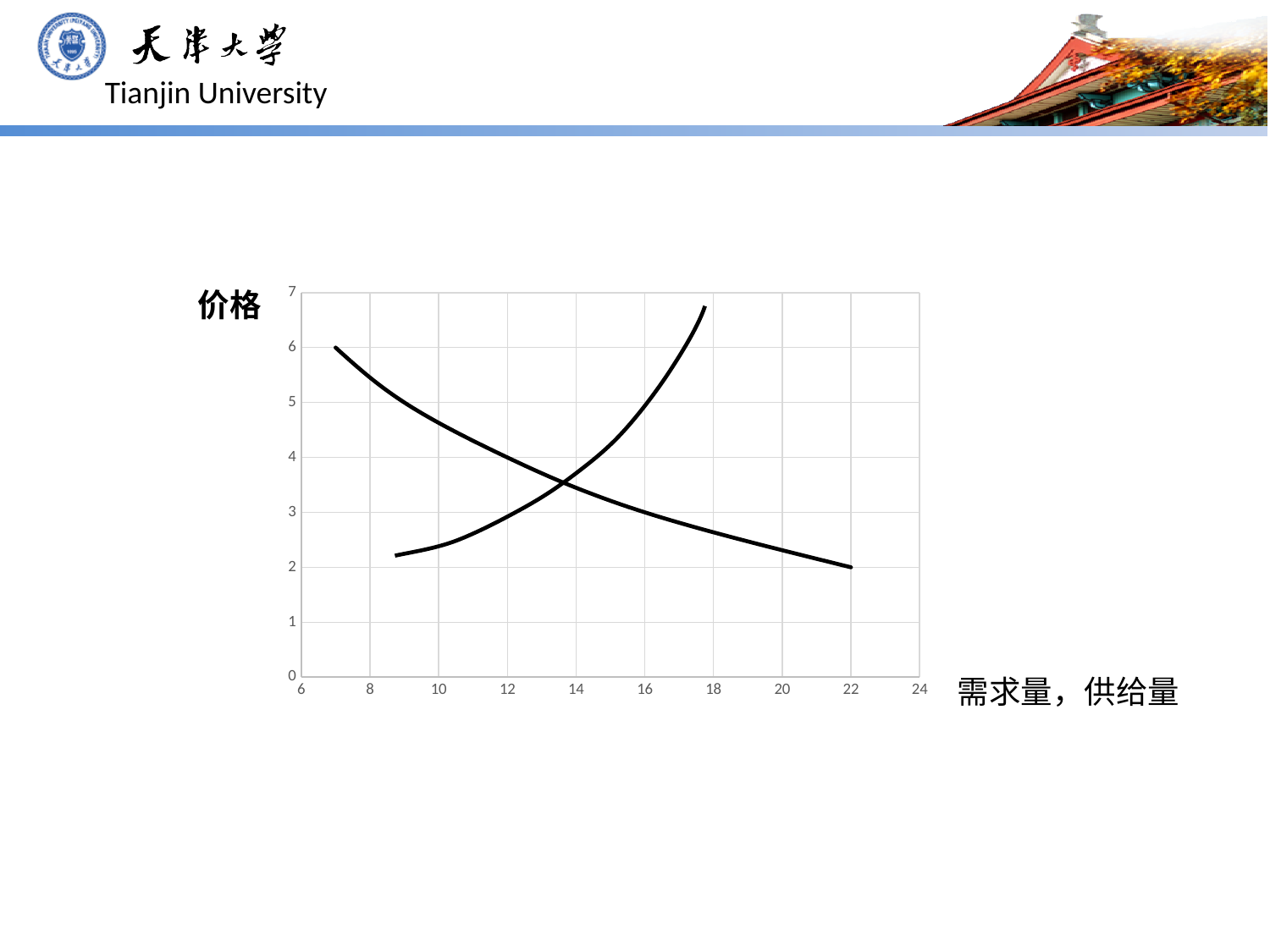
How many curves are plotted on the chart? 2 Is the value of the downward-sloping curve at x = 20 greater or less than 3? less Is the value of the upward-sloping curve at x = 10 greater or less than 3? less At the point where the two curves cross, is the price greater or less than 3? greater What is the label on the horizontal axis of the chart? 需求量，供给量 Does the curve that starts at the lower left rise or fall as the x value increases? rise Does the curve that starts at the upper left rise or fall as the x value increases? fall What kind of chart is shown on the slide? line chart Which curve reaches a higher value at x = 16, the upward-sloping curve or the downward-sloping curve? the upward-sloping curve What is the label on the vertical axis of the chart? 价格